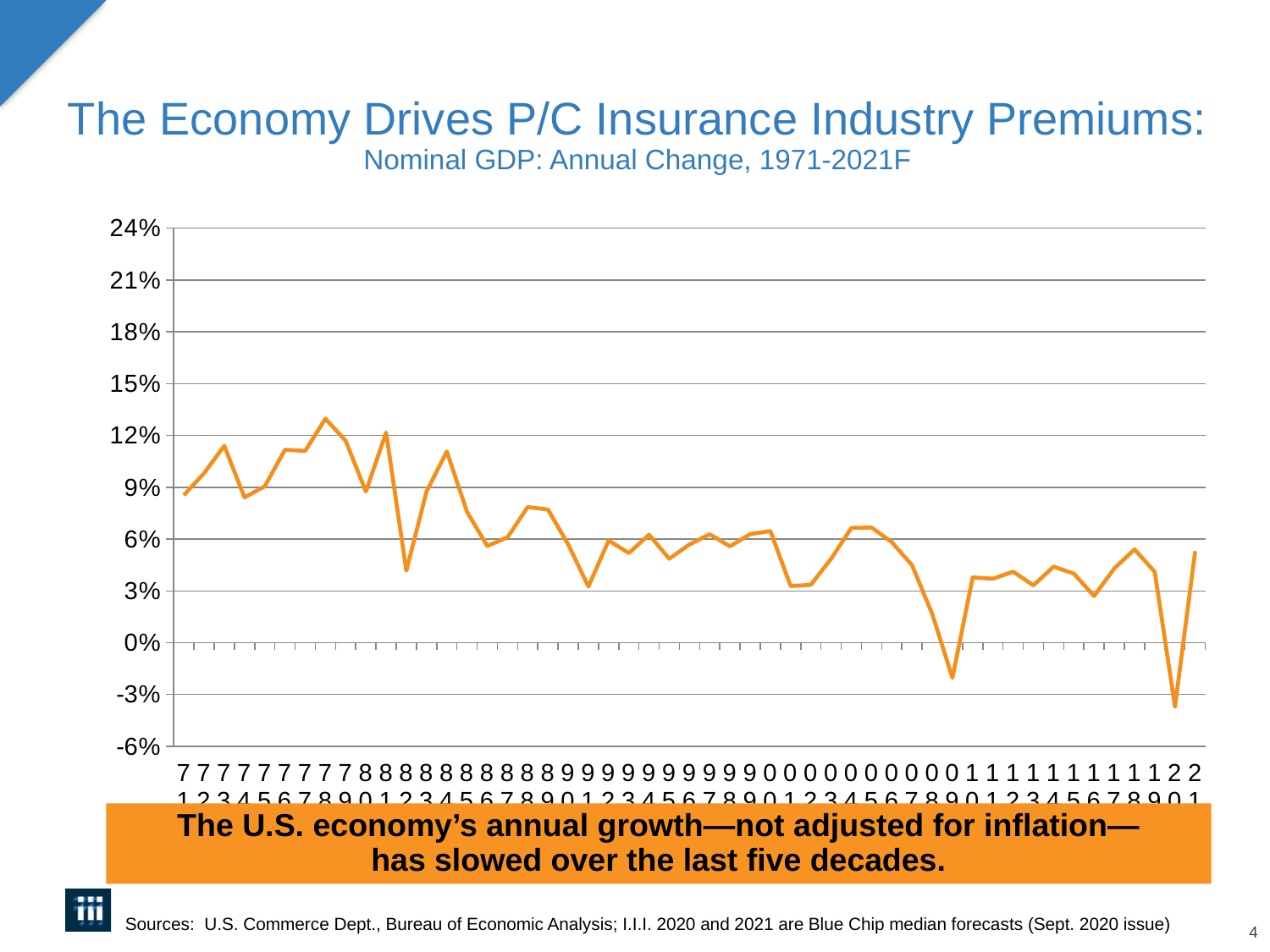
What is the subtitle of the chart? Nominal GDP: Annual Change, 1971-2021F Is the value for 2009 greater or less than 0%? less Is the value for 2020 greater or less than -3%? less Is the value for 1982 greater or less than 6%? less How many years (data points) are plotted on the chart? 51 In which year does the nominal GDP annual change reach its highest value? 1978 Which year has the larger nominal GDP change, 1981 or 1982? 1981 Which year has the larger nominal GDP change, 2009 or 2020? 2009 What kind of chart is shown on the slide? line chart In which year does the nominal GDP annual change reach its lowest value? 2020 Over the full period from 1971 to 2021, does nominal GDP annual growth generally rise or fall? fall